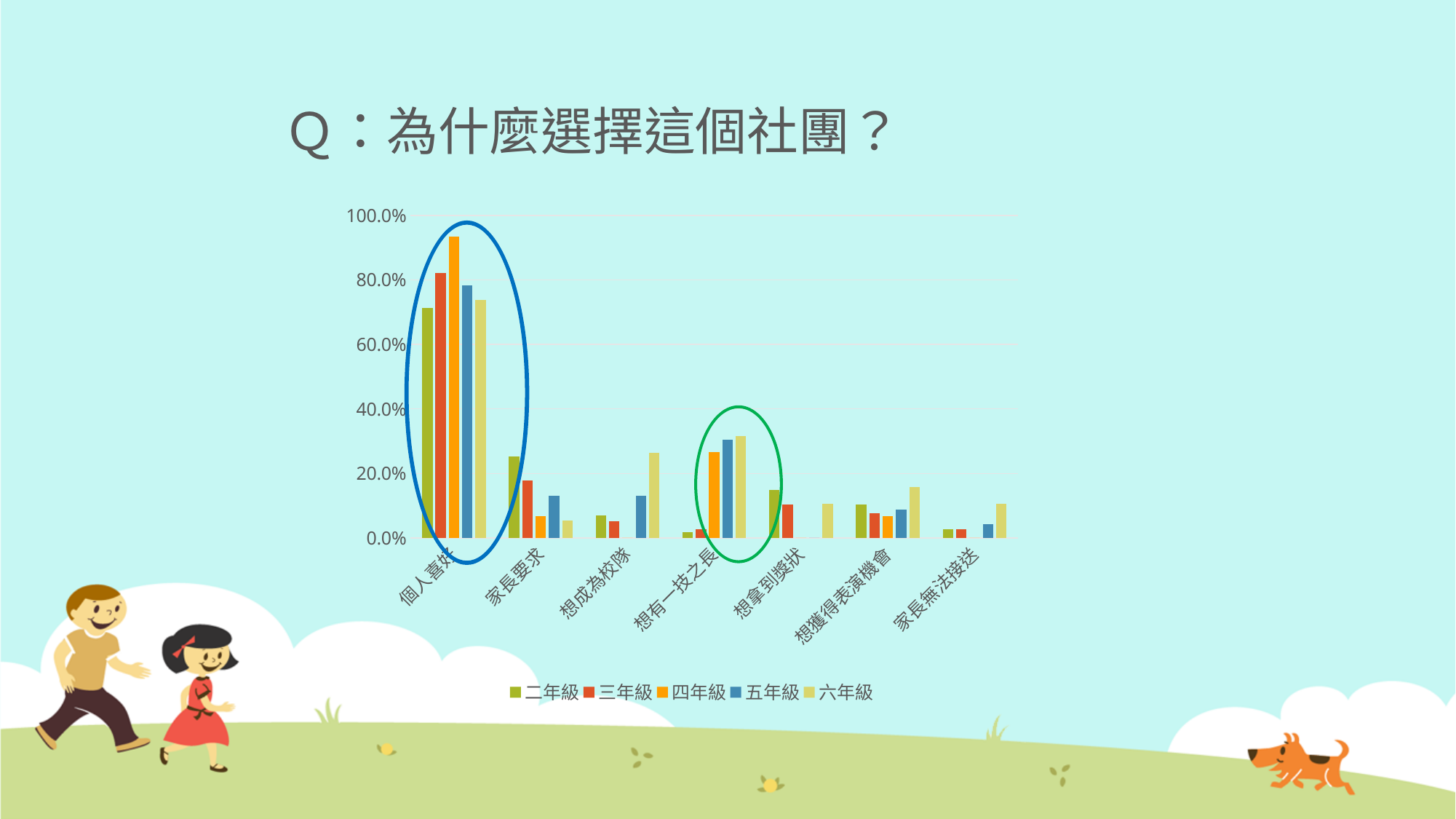
Is the value for 五年級 in the category 家長要求 greater or less than 20.0%? less What kind of chart is shown on the slide? bar chart What is the title shown above the chart? Q：為什麼選擇這個社團？ Is the value for 二年級 in the category 個人喜好 greater or less than 60.0%? greater Which category has the highest bars overall in the chart? 個人喜好 Is the value for 四年級 in the category 個人喜好 greater or less than 80.0%? greater In the category 想有一技之長, which is larger: the value for 二年級 or the value for 六年級? 六年級 For the category 個人喜好, which series has the highest bar? 四年級 How many series does the chart's legend list? 5 How many categories are shown along the x axis of the chart? 7 In the category 家長要求, which is larger: the value for 二年級 or the value for 三年級? 二年級